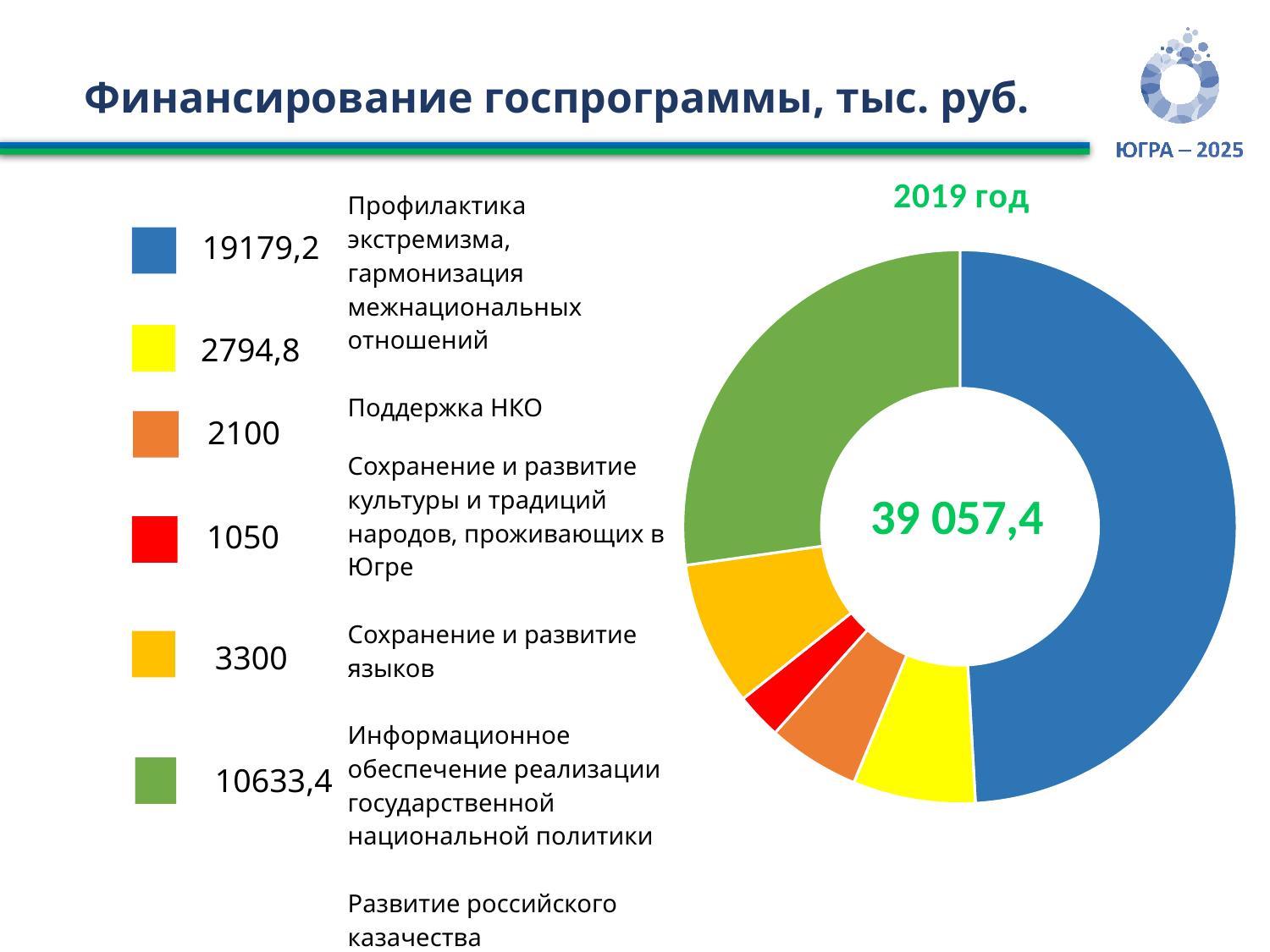
What is the difference between the blue segment (19179,2) and the green segment (10633,4)? 8545,8 Which segment has the smallest value? Red (1050) What value does the yellow segment of the chart represent? 2794,8 What type of chart is shown on the slide? Donut (pie) chart Which is larger, the amber segment (3300) or the orange segment (2100)? Amber (3300) Which segment has the largest value? Blue (19179,2) Which year does the chart refer to? 2019 год What is the total value shown in the centre of the donut chart? 39 057,4 What value does the blue segment of the chart represent? 19179,2 How many segments does the donut chart have? 6 What value does the green segment of the chart represent? 10633,4 What value does the red segment of the chart represent? 1050